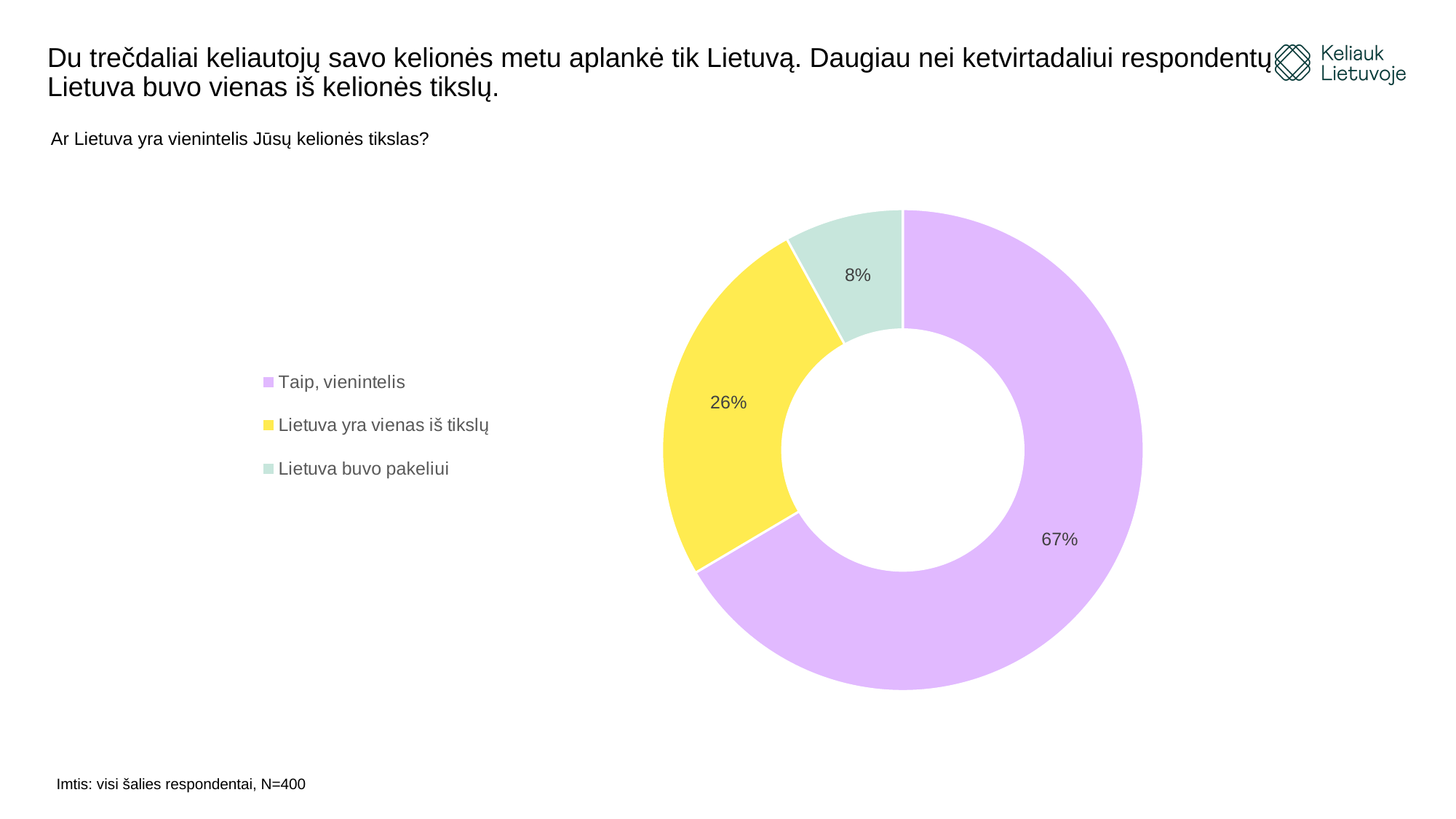
Which answer category has the smallest share? Lietuva buvo pakeliui What share of respondents answered "Taip, vienintelis"? 67% Which is larger: the share for "Lietuva yra vienas iš tikslų" or for "Lietuva buvo pakeliui"? Lietuva yra vienas iš tikslų Which answer category has the largest share? Taip, vienintelis Which colour represents "Lietuva yra vienas iš tikslų" in the chart? Yellow What is the difference in percentage points between "Lietuva yra vienas iš tikslų" and "Lietuva buvo pakeliui"? 18 percentage points What kind of chart is shown on the slide? Pie chart (doughnut) What is the difference in percentage points between "Taip, vienintelis" and "Lietuva yra vienas iš tikslų"? 41 percentage points What question is the chart based on, as written above it? Ar Lietuva yra vienintelis Jūsų kelionės tikslas? What share of respondents answered "Lietuva buvo pakeliui"? 8% How many categories does the chart show? 3 What share of respondents answered "Lietuva yra vienas iš tikslų"? 26%